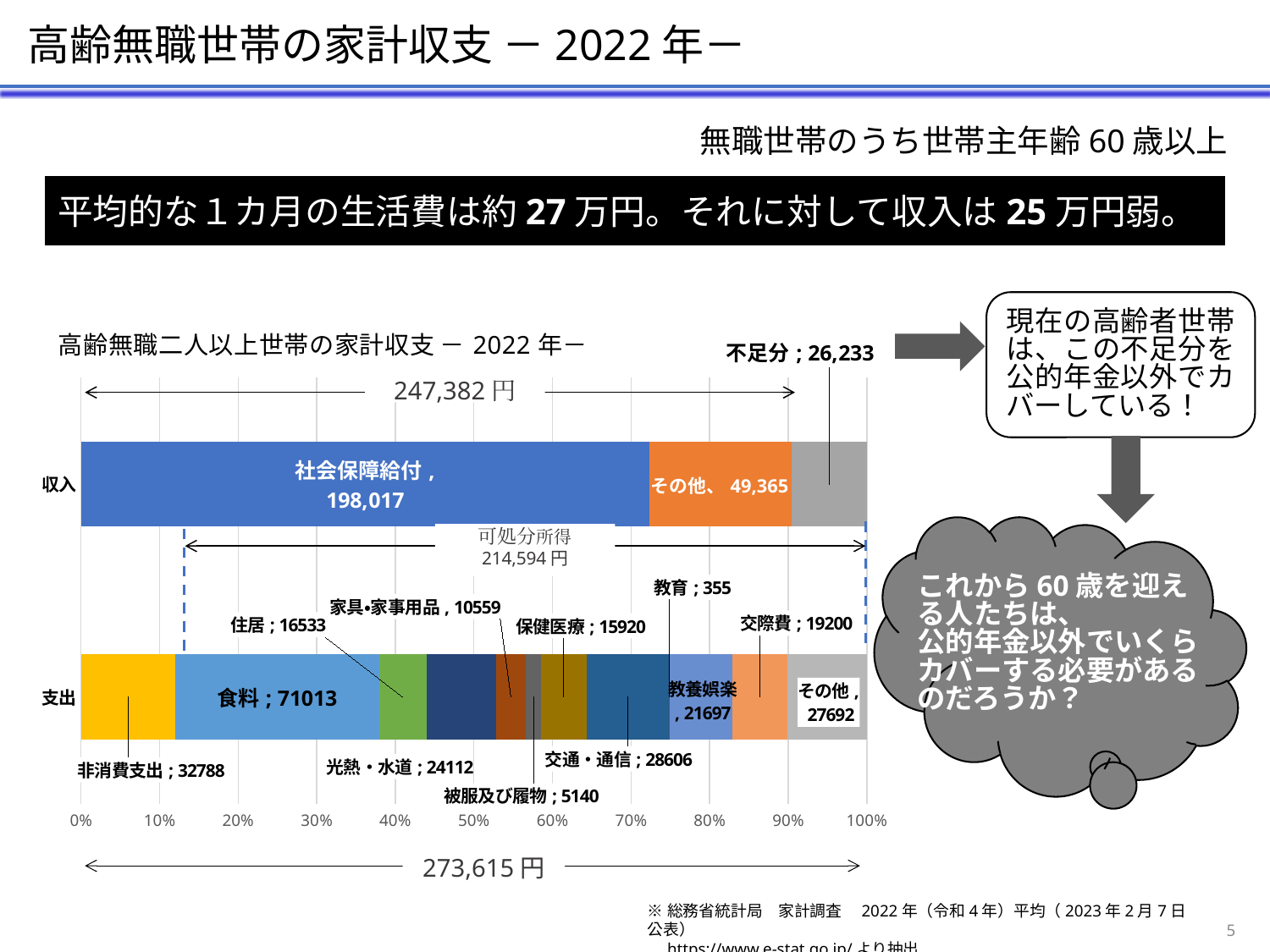
Which is larger in the 支出 bar, 交際費 or 保健医療? 交際費 What is the value of 社会保障給付 in the 収入 bar? 198,017 What is the value labelled 不足分? 26,233 What type of chart is shown on the slide? Stacked bar chart Which segment of the 支出 bar has the largest value? 食料 What total amount is shown for the 支出 bar? 273,615 円 What is the value of 食料 in the 支出 bar? 71013 What is the value of 教育 in the 支出 bar? 355 What total amount is shown for the 収入 bar (excluding 不足分)? 247,382 円 Which segment of the 支出 bar has the smallest value? 教育 What is the difference between 光熱・水道 and 住居 in the 支出 bar? 7579 What is the value of 交通・通信 in the 支出 bar? 28606